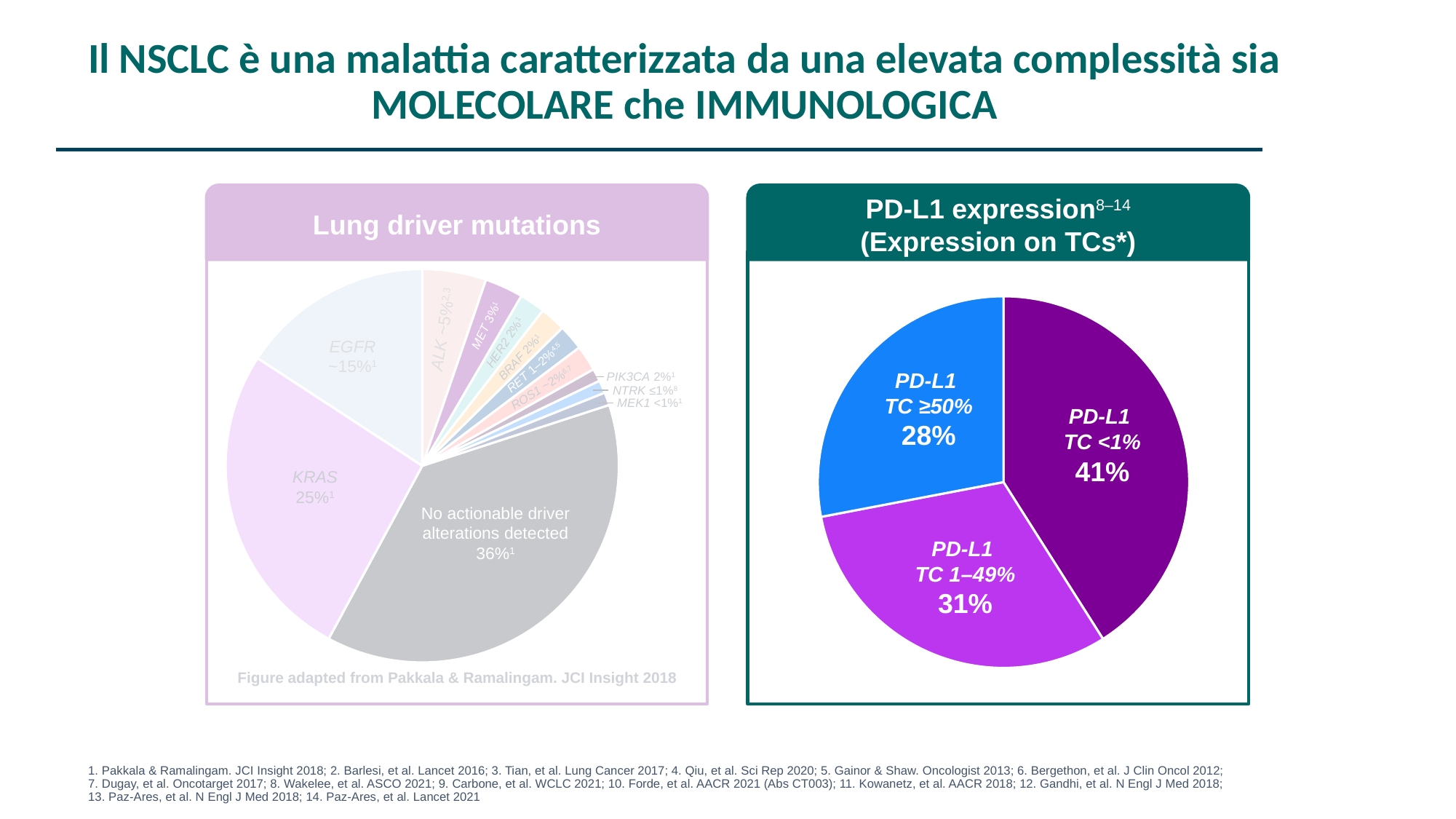
What type of chart is used in the 'PD-L1 expression' panel? Pie chart In the 'Lung driver mutations' chart, what percentage is shown for KRAS? 25% In the 'PD-L1 expression' chart, what is the difference in percentage points between the PD-L1 TC <1% slice and the PD-L1 TC ≥50% slice? 13 percentage points In the 'Lung driver mutations' chart, which is larger: the KRAS slice or the EGFR slice? KRAS In the 'PD-L1 expression' chart, what percentage of patients have PD-L1 TC <1%? 41% In the 'PD-L1 expression' chart, what percentage is shown for PD-L1 TC 1–49%? 31% In the 'Lung driver mutations' chart, what percentage of cases have no actionable driver alterations detected? 36% In the 'PD-L1 expression' chart, which PD-L1 category has the largest slice? PD-L1 TC <1% In the 'PD-L1 expression' chart, how many slices does the pie have? 3 In the 'Lung driver mutations' chart, what is the difference in percentage points between 'No actionable driver alterations detected' and KRAS? 11 percentage points In the 'Lung driver mutations' chart, what percentage is shown for MET? 3% In the 'PD-L1 expression' chart, which PD-L1 category has the smallest slice? PD-L1 TC ≥50%